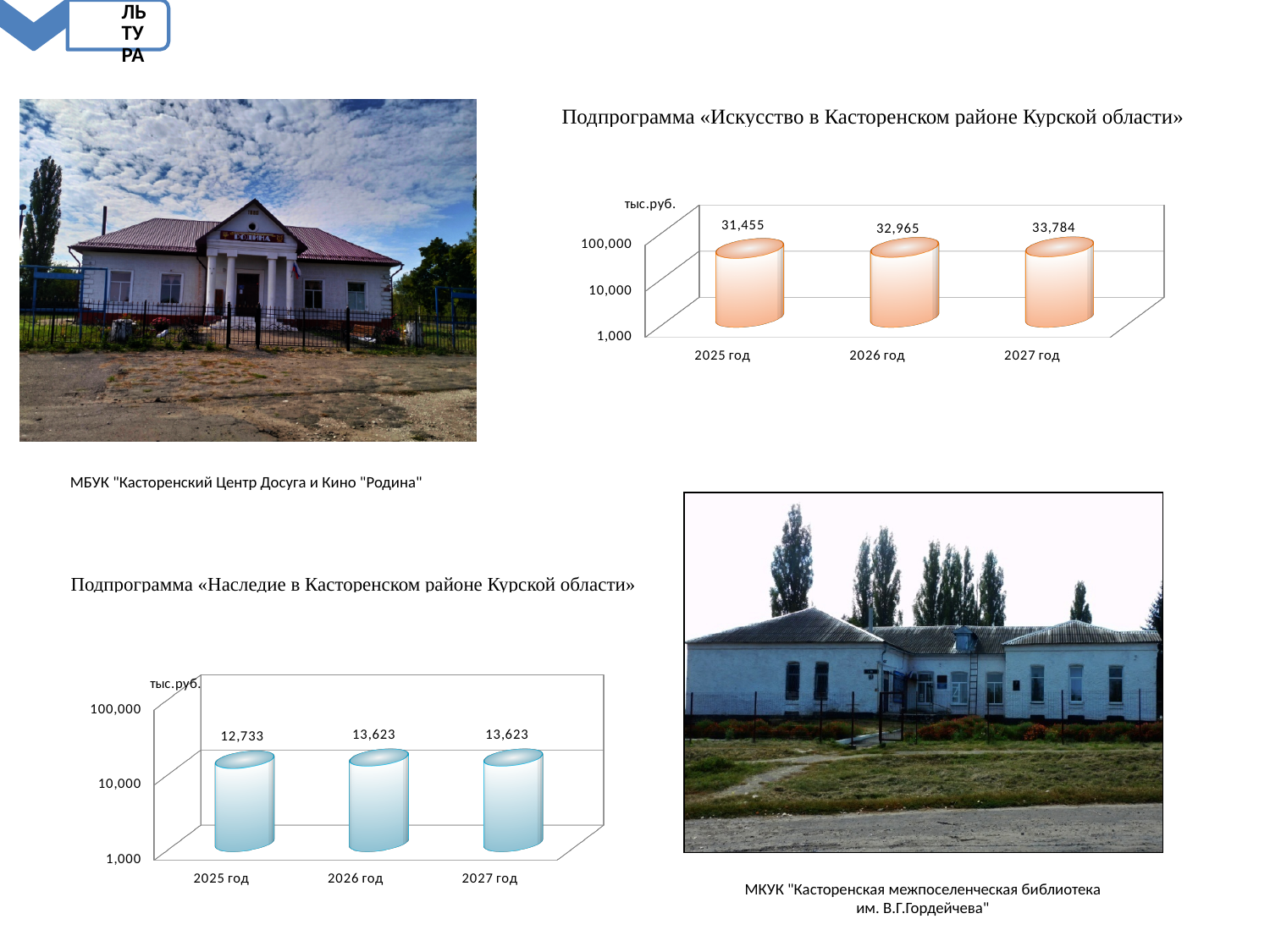
In the chart for the subprogram «Наследие в Касторенском районе Курской области» (bottom left), what is the difference between the values for 2026 год and 2025 год? 890 In the chart for the subprogram «Наследие в Касторенском районе Курской области» (bottom left), which year has the lowest value? 2025 год In the chart for the subprogram «Искусство в Касторенском районе Курской области» (top right), what is the difference between the values for 2026 год and 2025 год? 1,510 In the chart for the subprogram «Наследие в Касторенском районе Курской области» (bottom left), what is the value for 2025 год? 12,733 In the chart for the subprogram «Искусство в Касторенском районе Курской области» (top right), what is the value for 2027 год? 33,784 In the chart for the subprogram «Наследие в Касторенском районе Курской области» (bottom left), how many years are shown on the x axis? 3 In the chart for the subprogram «Наследие в Касторенском районе Курской области» (bottom left), what is the value for 2026 год? 13,623 In the chart for the subprogram «Искусство в Касторенском районе Курской области» (top right), do the values rise or fall from 2025 год to 2027 год? rise What kind of chart is used for the subprogram «Искусство в Касторенском районе Курской области» (top right)? bar chart In the chart for the subprogram «Искусство в Касторенском районе Курской области» (top right), what is the value for 2025 год? 31,455 In the chart for the subprogram «Искусство в Касторенском районе Курской области» (top right), which year has the highest value? 2027 год Which is larger: the 2027 год value in the «Искусство» chart (top right) or the 2027 год value in the «Наследие» chart (bottom left)? «Искусство» chart, 33,784